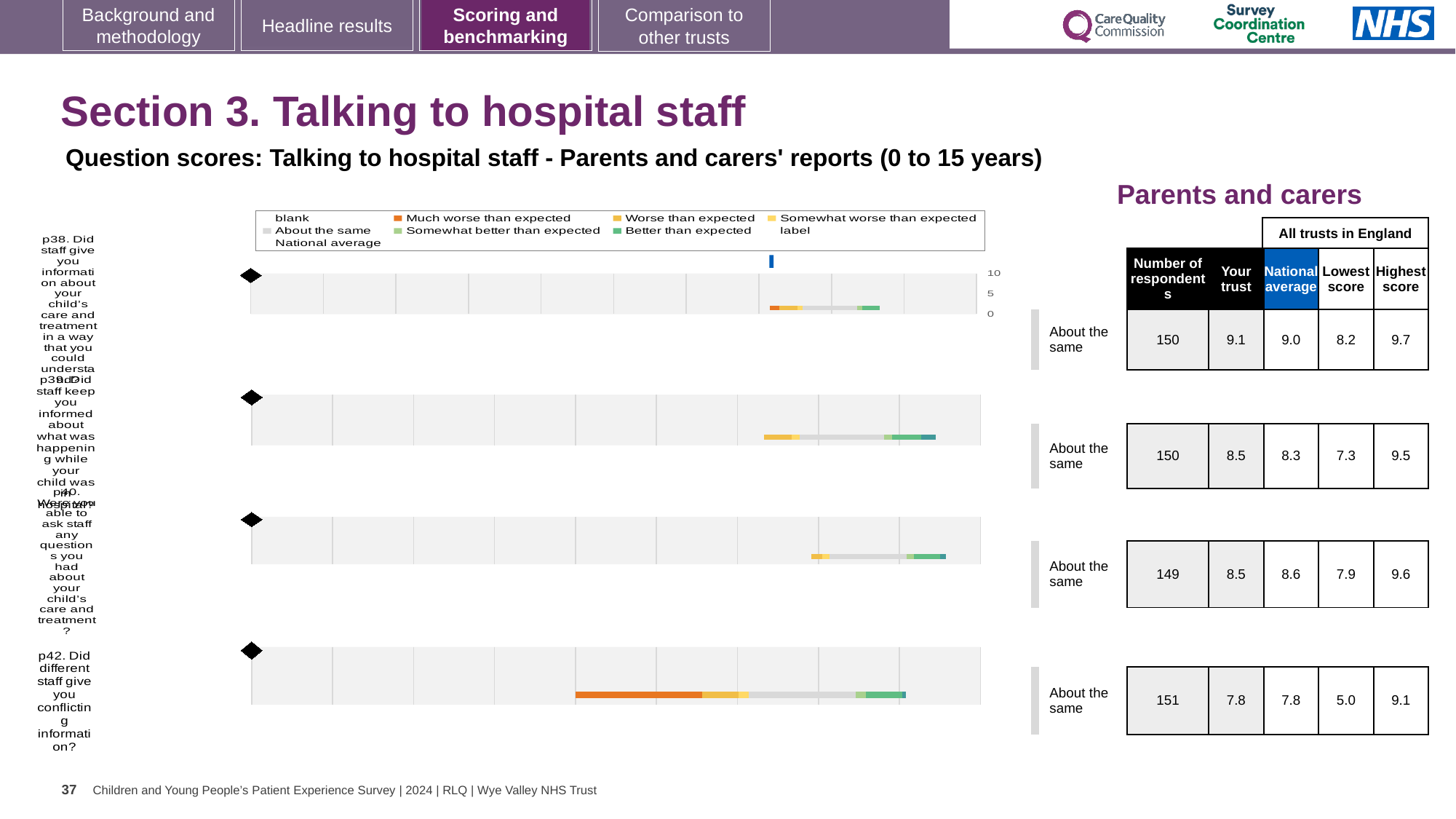
Which question has the lowest 'Your trust' score on this slide? p42 How many respondents answered p42 (different staff giving conflicting information)? 151 In the chart legend, what colour represents 'Much worse than expected'? orange For p38, which is larger: the 'Your trust' score or the national average? Your trust How many survey questions are plotted as bars on this slide? 4 For p42, what is the difference between the highest score (9.1) and the lowest score (5.0) across all trusts in England? 4.1 Which question has the highest 'Highest score' value across all trusts in England? p38 What is the national average score for p42 (different staff giving conflicting information)? 7.8 In the chart legend, what colour represents 'Better than expected'? green What is the 'Your trust' score for p38 (staff giving information about your child's care and treatment in a way you could understand)? 9.1 What kind of chart is used to show the question scores on this slide? bar chart What benchmark category is shown for p38? About the same